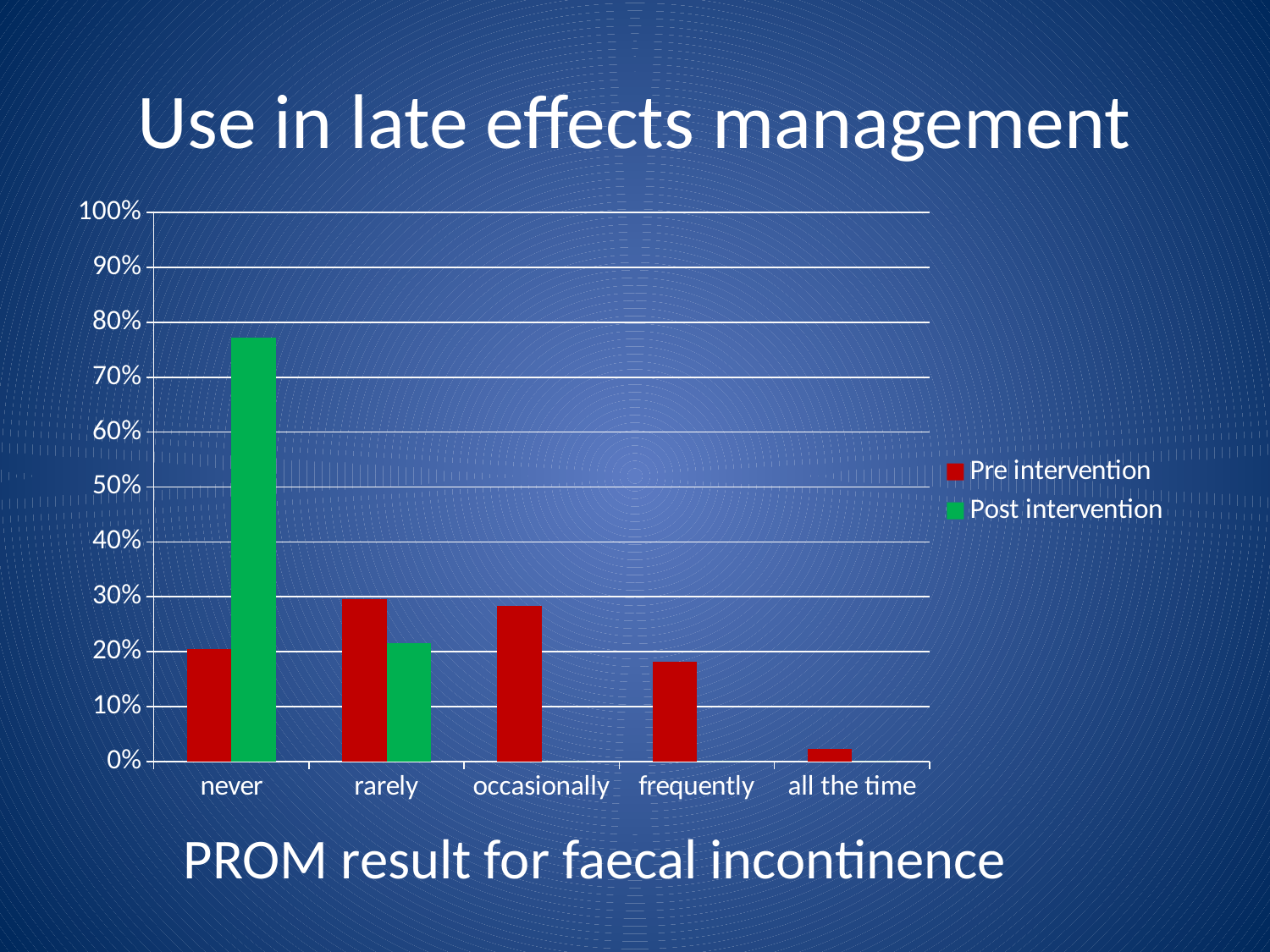
For the never category, which is larger: Pre intervention or Post intervention? Post intervention Is the Post intervention value for never greater or less than 70%? greater What colour represents the Post intervention series? green What kind of chart is shown on the slide? bar chart For the rarely category, which is larger: Pre intervention or Post intervention? Pre intervention Which category has the lowest Pre intervention value? all the time How many categories are shown on the x axis? 5 Is the Pre intervention value for frequently greater or less than 10%? greater Which category has the highest Post intervention value? never Is the Pre intervention value for all the time greater or less than 10%? less How many series does the legend list? 2